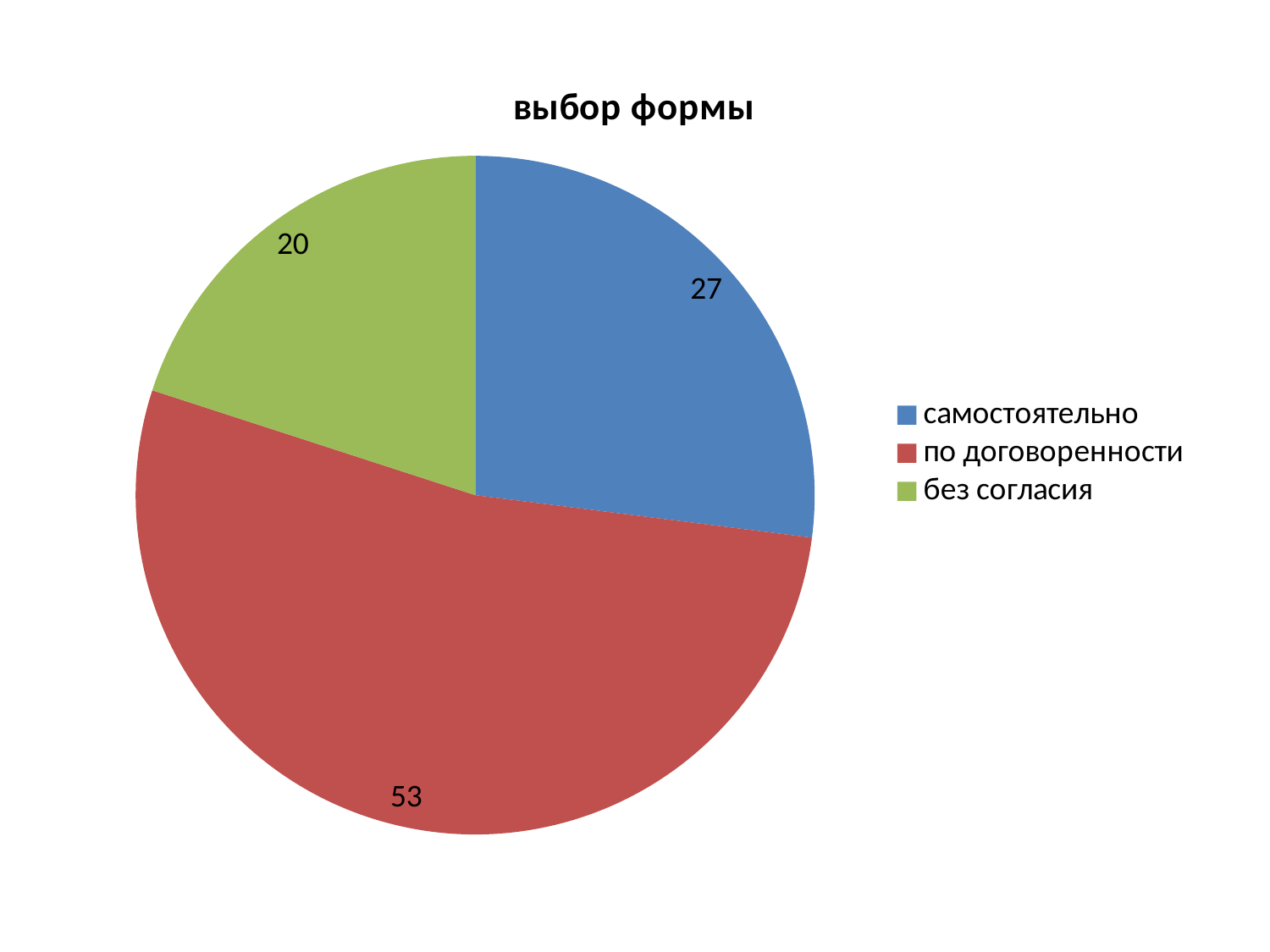
What is the difference between the values for самостоятельно and без согласия? 7 What is the value for самостоятельно? 27 Which category has the smallest slice? без согласия What share of the pie does по договоренности represent? 53% How many slices does the pie chart have? 3 What is the title of the chart? выбор формы What is the value for без согласия? 20 Which category has the largest slice? по договоренности Which is larger, самостоятельно or без согласия? самостоятельно What is the value for по договоренности? 53 What kind of chart is shown on the slide? pie chart What is the difference between the values for по договоренности and самостоятельно? 26